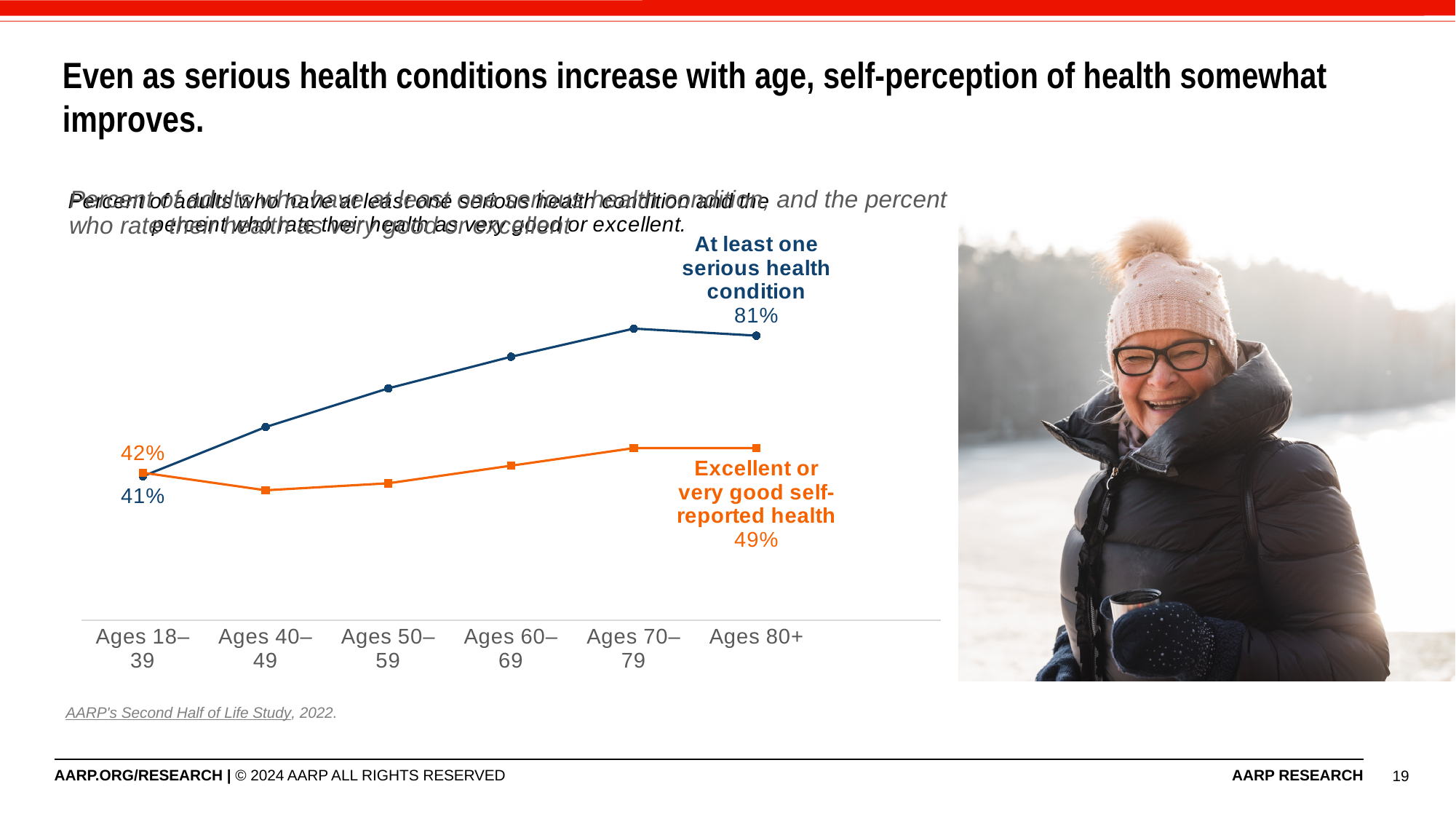
What is the value for 'Excellent or very good self-reported health' at Ages 80+? 49% What is the value for 'At least one serious health condition' at Ages 80+? 81% How many data series are plotted in the chart? 2 How much higher is the 'At least one serious health condition' value at Ages 80+ than at Ages 18–39? 40 percentage points What type of chart is shown on the slide? Line chart What is the value for 'At least one serious health condition' at Ages 18–39? 41% Which age group has the lowest value for 'Excellent or very good self-reported health'? Ages 40–49 How many age groups are shown on the x axis of the chart? 6 Does the 'At least one serious health condition' line rise or fall from Ages 18–39 to Ages 70–79? Rises What is the value for 'Excellent or very good self-reported health' at Ages 18–39? 42% At Ages 80+, what is the difference between the 'At least one serious health condition' value and the 'Excellent or very good self-reported health' value? 32 percentage points At Ages 80+, which series has the higher value: 'At least one serious health condition' or 'Excellent or very good self-reported health'? At least one serious health condition